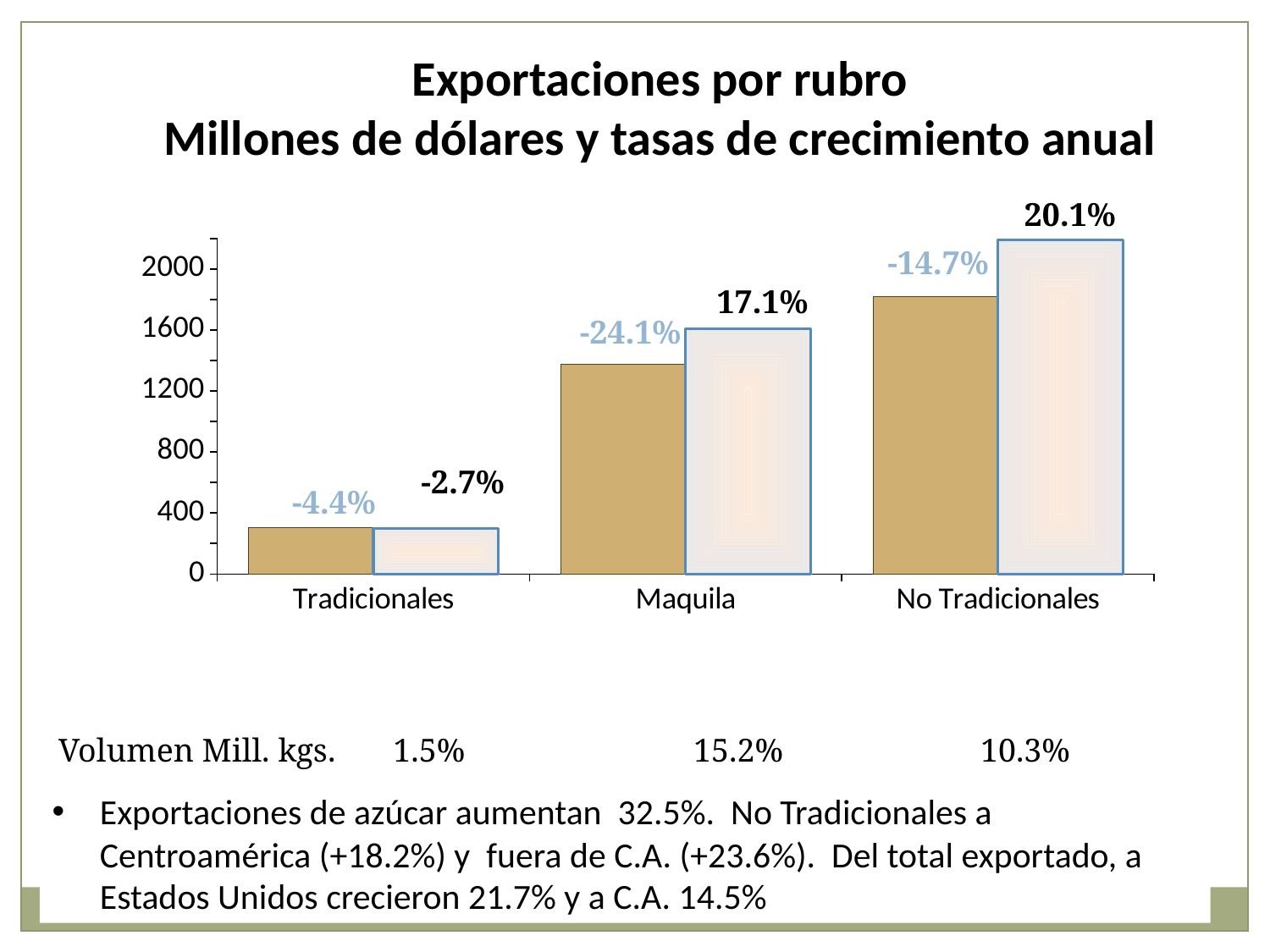
For Maquila, which bar is taller, the tan bar or the light bar? the light bar Which category has the shortest bars in the chart? Tradicionales How many categories are shown on the x axis of the chart? 3 What growth rate is printed in blue above the tan bar for Maquila? -24.1% Is the value of the light bar for No Tradicionales greater or less than 2000? greater What growth rate is printed in black above the light bar for Tradicionales? -2.7% Is the value of the tan bar for Maquila greater or less than 1200? greater Which category has the tallest bars in the chart? No Tradicionales What growth rate is printed in blue above the tan bar for No Tradicionales? -14.7% What kind of chart is shown on the slide? bar chart What growth rate is printed above the light bar for No Tradicionales? 20.1% What growth rate is printed in black above the light bar for Maquila? 17.1%